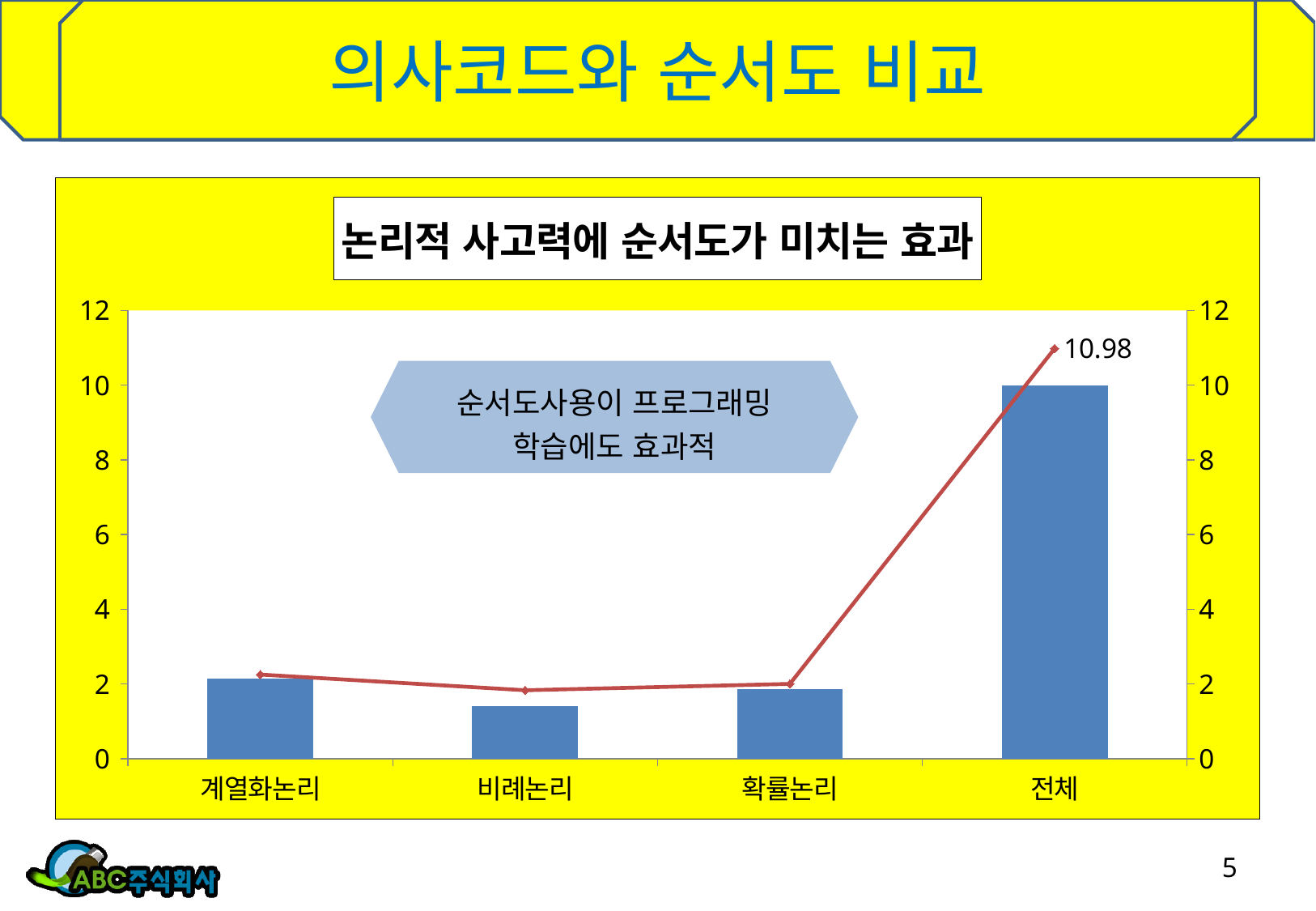
Is the bar value for 전체 greater or less than 8? greater What value is labelled on the line at 전체? 10.98 Which category has the shortest bar? 비례논리 Which category has the tallest bar? 전체 How many categories are shown on the x axis of the chart? 4 Which has the taller bar, 계열화논리 or 비례논리? 계열화논리 Which has the taller bar, 확률논리 or 비례논리? 확률논리 Does the line rise or fall from 확률논리 to 전체? rises What is the title of the chart? 논리적 사고력에 순서도가 미치는 효과 What kind of chart is shown on the slide? bar chart with a line Is the bar value for 비례논리 greater or less than 2? less What colour are the bars in the chart? blue